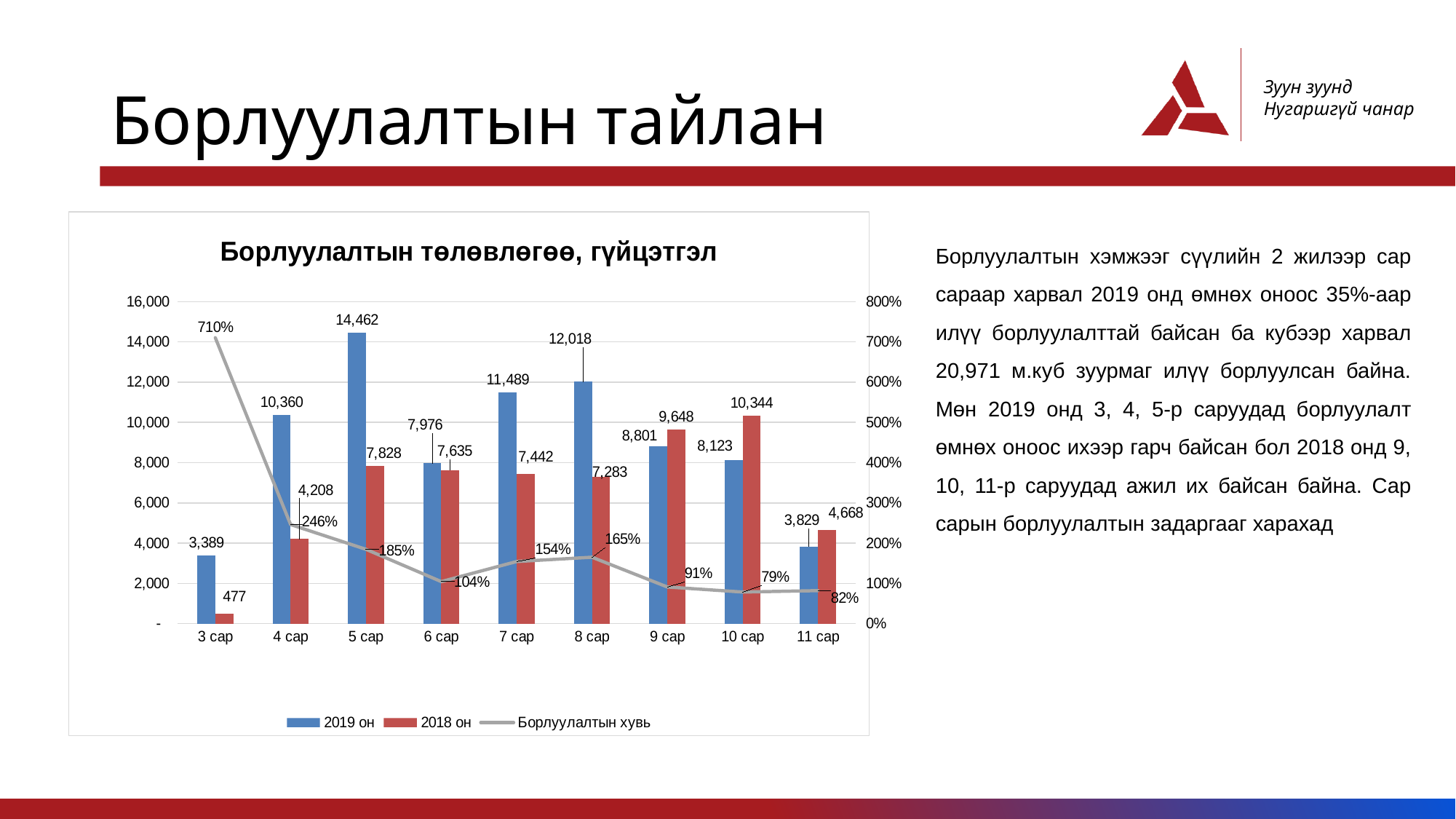
Does the Борлуулалтын хувь line rise or fall from 3 сар to 6 сар? Fall How many months are shown on the x axis? 9 What is the value for 2018 он in 10 сар? 10,344 What is the difference between the 2019 он and 2018 он values in 8 сар? 4,735 Which month has the highest value for 2019 он? 5 сар What is the title of the chart? Борлуулалтын төлөвлөгөө, гүйцэтгэл What is the value for 2019 он in 5 сар? 14,462 What kind of chart is this? Combined bar and line chart What is the Борлуулалтын хувь value for 3 сар? 710% Which month has the lowest value for 2018 он? 3 сар How many series does the legend list? 3 In 9 сар, which series has the larger value, 2019 он or 2018 он? 2018 он